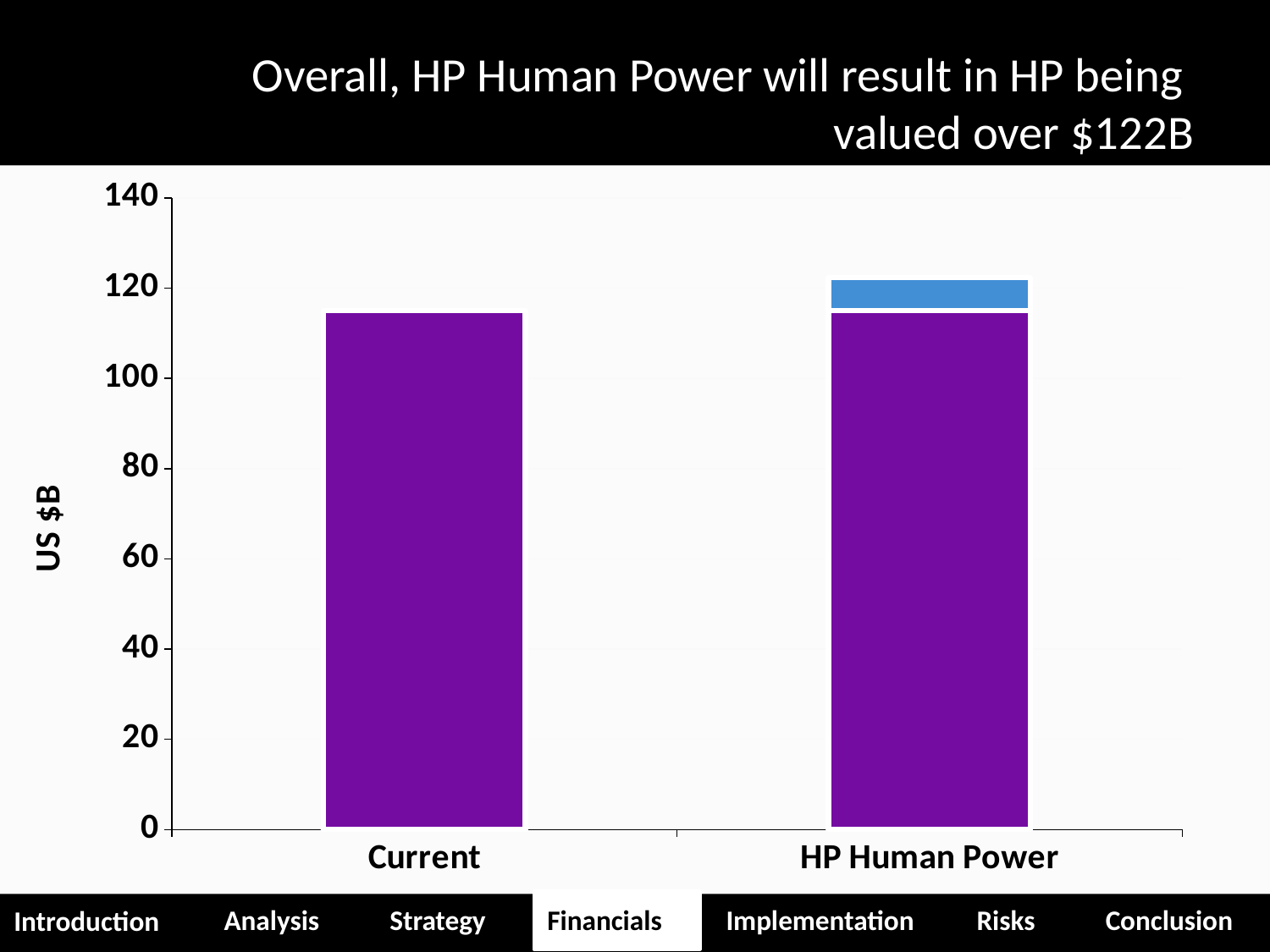
How many categories are shown on the x axis? 2 How many coloured segments make up the HP Human Power bar? 2 Is the value for Current greater or less than 100? greater Is the total value for HP Human Power greater or less than 100? greater Which category has the highest total bar? HP Human Power Is the value for Current greater or less than 120? less What is the label on the y axis? US $B What kind of chart is shown on the slide? bar chart Which category has the lowest total bar? Current Which category has the taller bar, Current or HP Human Power? HP Human Power Do the bar totals rise or fall from Current to HP Human Power? rise